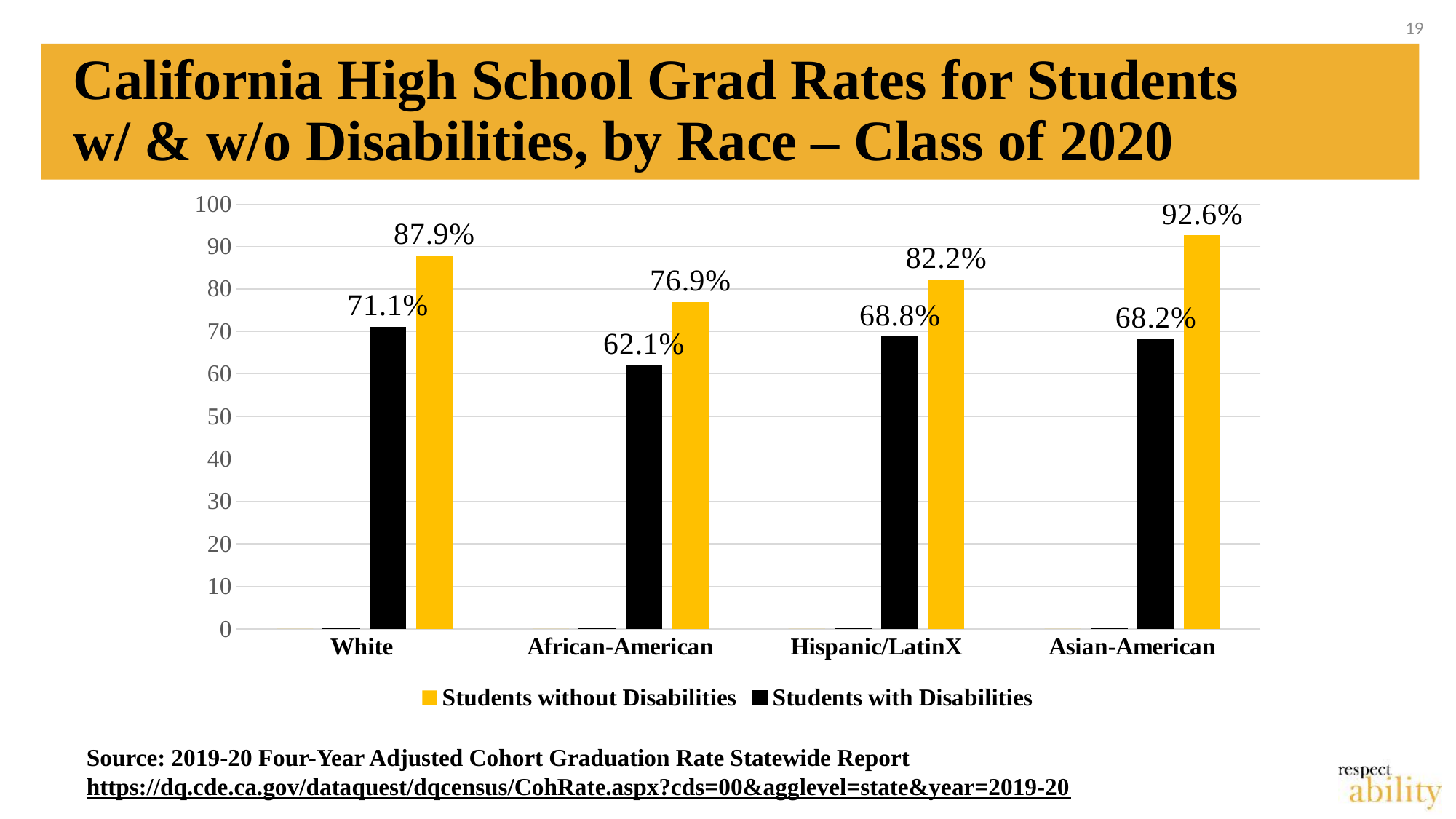
What is the difference between the graduation rates of Asian-American students without disabilities and with disabilities? 24.4% Is the graduation rate for Hispanic/LatinX students with disabilities greater or less than 70? less How many series does the legend list? 2 What is the graduation rate for African-American students with disabilities? 62.1% What kind of chart is shown on the slide? Bar chart What is the graduation rate for Asian-American students with disabilities? 68.2% Which race group has the lowest graduation rate for students with disabilities? African-American Which race group has the highest graduation rate for students without disabilities? Asian-American What is the graduation rate for White students without disabilities? 87.9% How many race categories are shown on the x axis? 4 What is the graduation rate for Hispanic/LatinX students without disabilities? 82.2% Which is larger: the graduation rate for White students with disabilities or for African-American students without disabilities? African-American students without disabilities